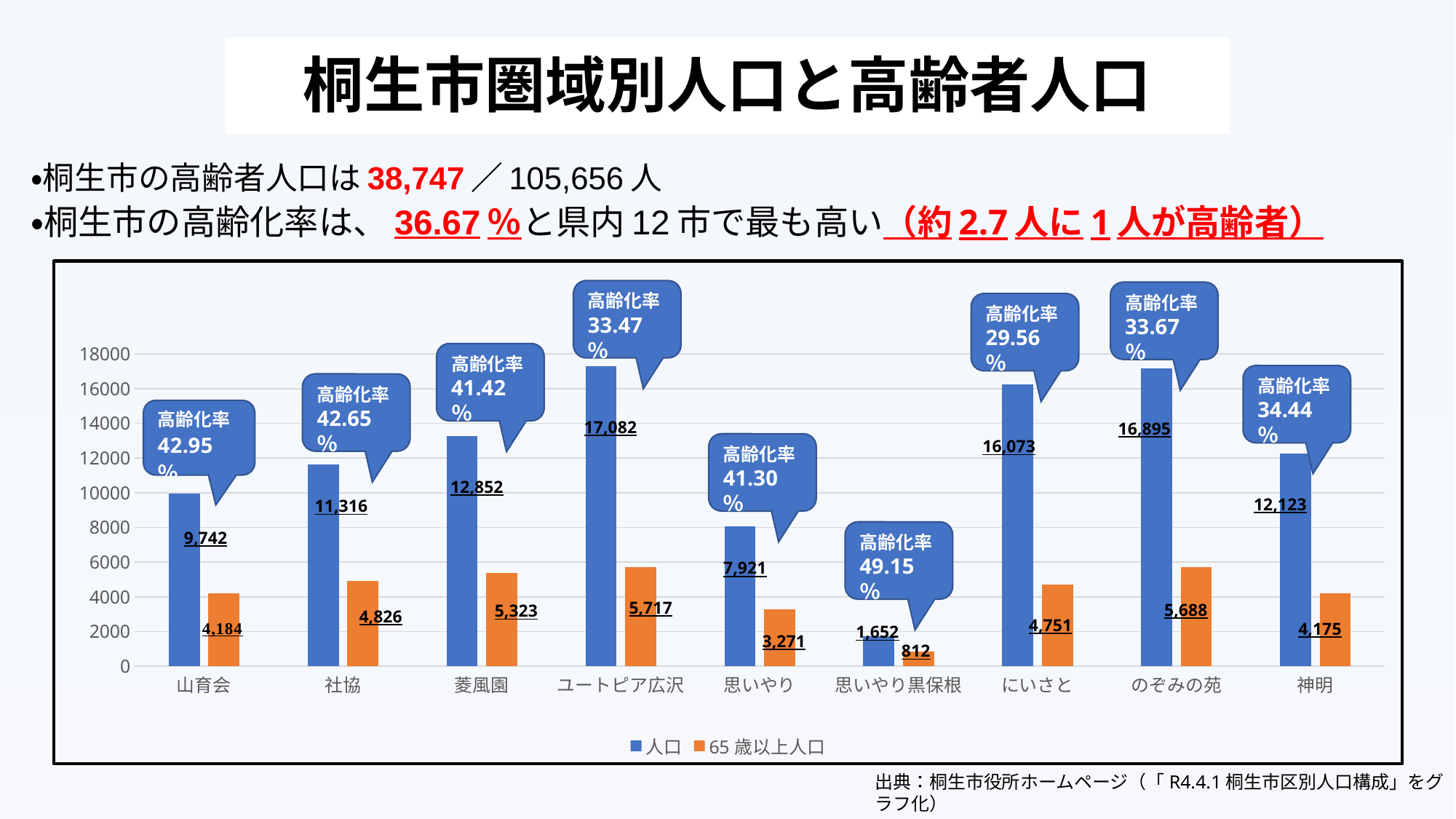
Which category has the highest 人口 value? ユートピア広沢 How many series does the chart legend list? 2 Which category has the lowest 65歳以上人口 value? 思いやり黒保根 What is the 人口 value for 思いやり黒保根? 1,652 What is the 65歳以上人口 value for のぞみの苑? 5,688 How many categories are shown on the x axis of the chart? 9 What 高齢化率 is shown in the callout for 思いやり黒保根? 49.15% Is the 人口 value for 社協 greater or less than 10000? greater What is the difference between the 人口 value and the 65歳以上人口 value for 神明? 7,948 Which is larger, the 人口 value for にいさと or the 人口 value for のぞみの苑? のぞみの苑 What is the 人口 value for ユートピア広沢? 17,082 What kind of chart is shown on the slide? bar chart